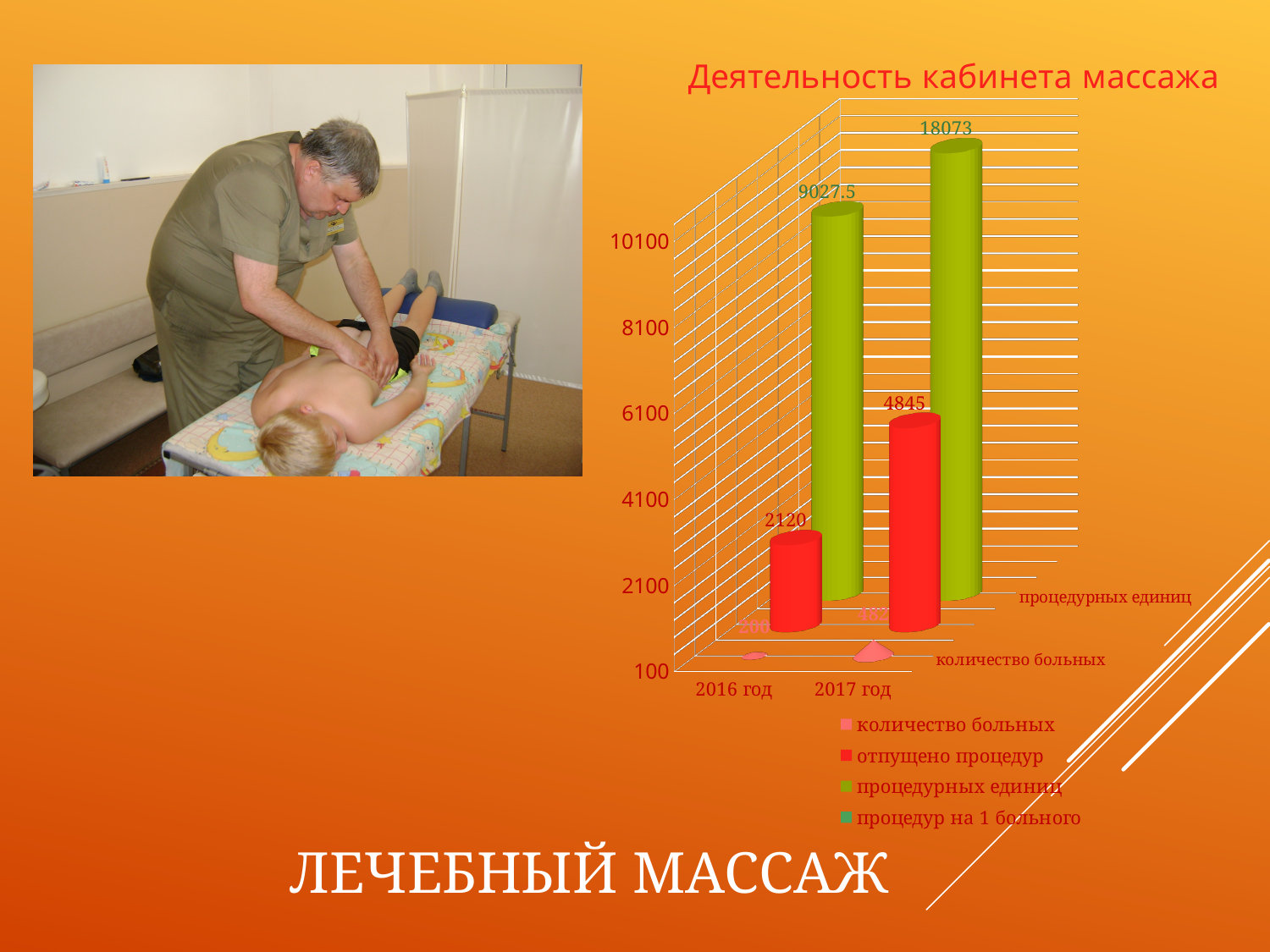
Which year has the higher value for 'процедурных единиц'? 2017 год What is the value of 'отпущено процедур' for 2017 год? 4845 Does the value of 'отпущено процедур' rise or fall from 2016 год to 2017 год? rise By how much did 'отпущено процедур' increase from 2016 год to 2017 год? 2725 How many series does the chart legend list? 4 What is the title of the chart? Деятельность кабинета массажа What is the value of 'процедурных единиц' for 2017 год? 18073 How many year categories are shown on the x axis of the chart? 2 What is the value of 'отпущено процедур' for 2016 год? 2120 What is the value of 'процедурных единиц' for 2016 год? 9027.5 What kind of chart is shown on the slide? bar chart